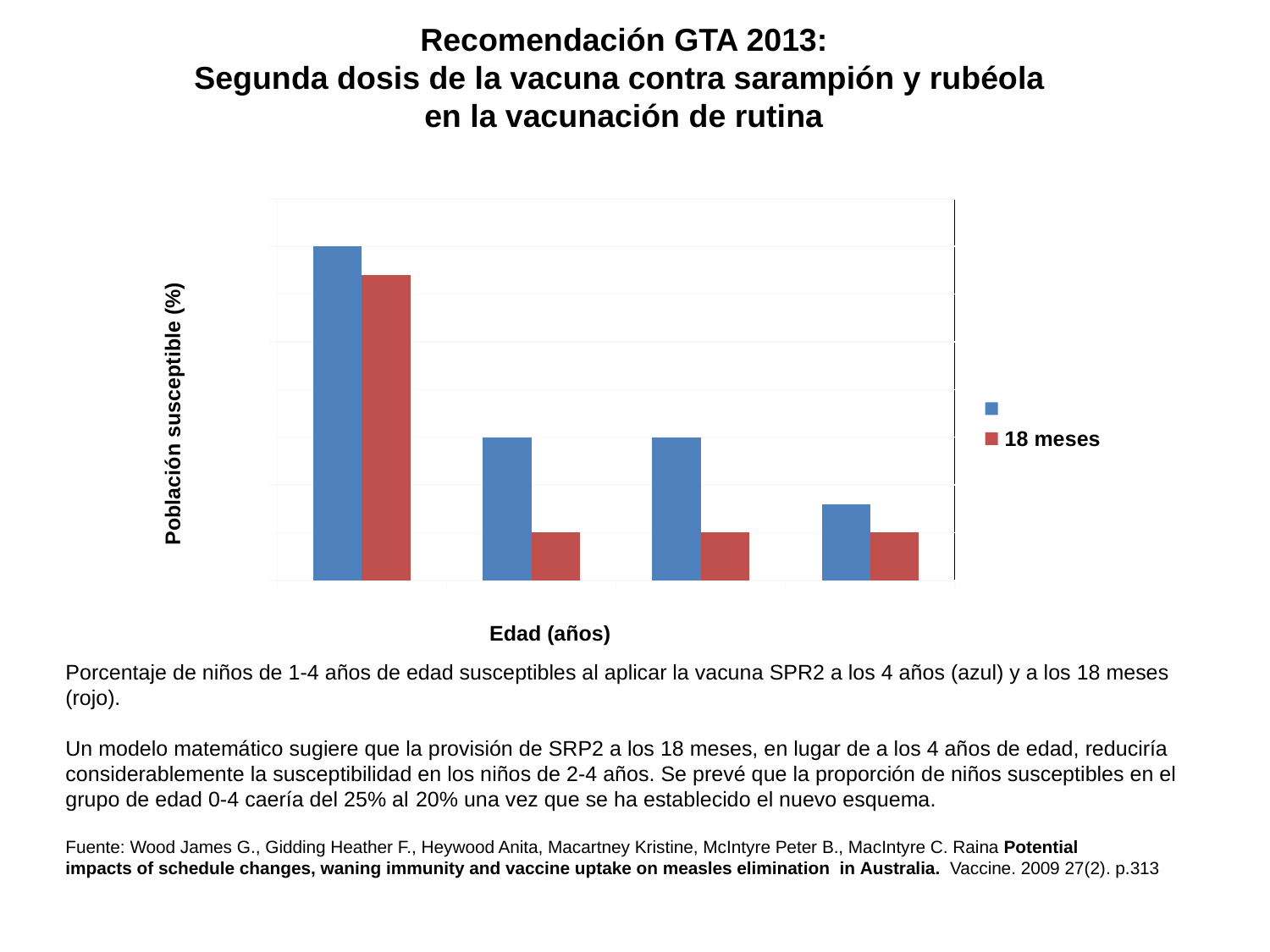
Which group of bars has the highest value for the '18 meses' (red) series? the first (leftmost) group How many groups of bars (age categories) are plotted along the x axis? 4 What is the title of the y axis? Población susceptible (%) In the first (leftmost) group, which bar is taller, the blue bar or the red '18 meses' bar? the blue bar What colour are the bars for the '18 meses' series? red In the second group of bars, which is larger, the blue series or the red '18 meses' series? the blue series Which group of bars has the highest value for the blue series? the first (leftmost) group What kind of chart is shown on the slide? bar chart Which series is labelled in the legend? 18 meses Do the blue bars rise or fall from left to right along the x axis? fall Which group of bars has the lowest value for the blue series? the fourth (rightmost) group How many series does the legend list? 2